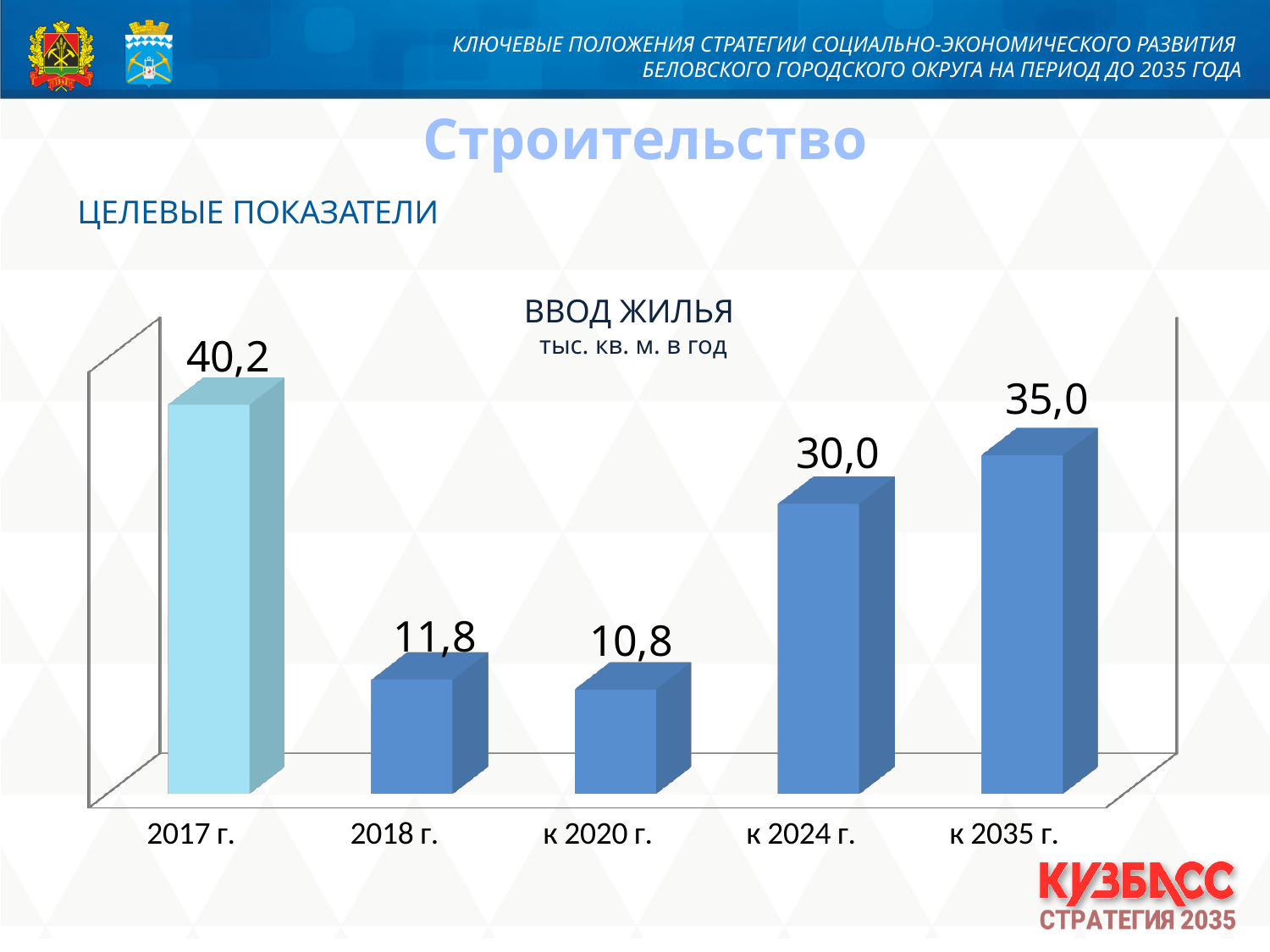
What kind of chart is shown on the slide? bar chart What is the value for к 2024 г.? 30,0 Which category has the highest value? 2017 г. What is the difference between the values for 2017 г. and 2018 г.? 28,4 What is the value for к 2035 г.? 35,0 What is the difference between the values for к 2035 г. and к 2024 г.? 5,0 Which category has the lowest value? к 2020 г. How many categories are shown on the chart? 5 Which is larger, the value for 2018 г. or the value for к 2020 г.? 2018 г. What unit is stated under the chart title? тыс. кв. м. в год What is the value for 2017 г.? 40,2 What is the title of the chart? ВВОД ЖИЛЬЯ